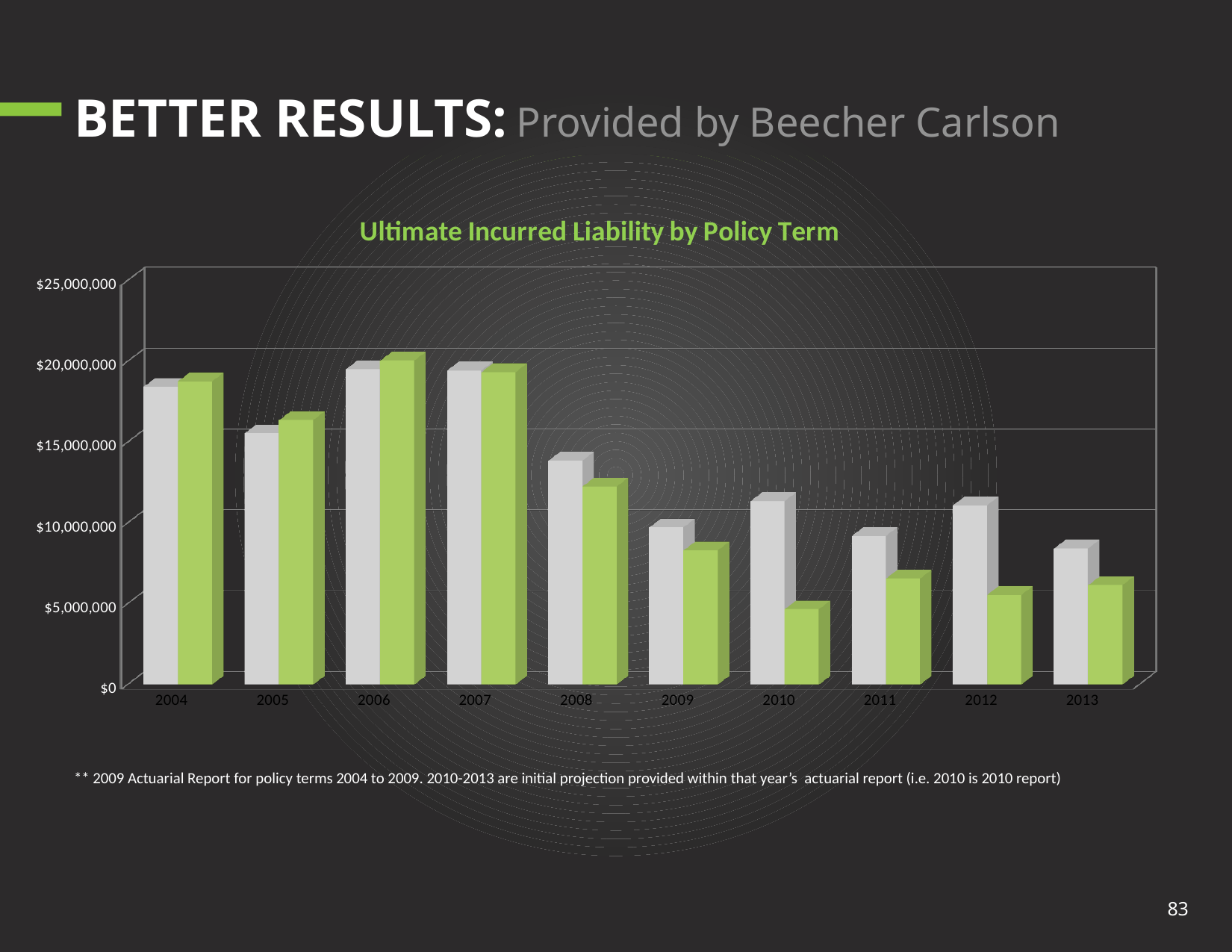
Is the grey bar for 2008 greater or less than $10,000,000? greater For 2010, which bar is taller, the grey bar or the green bar? Grey bar Is the green bar for 2009 greater or less than $10,000,000? less What kind of chart is shown on the slide? Bar chart What is the title of the chart? Ultimate Incurred Liability by Policy Term Overall, do the green bars rise or fall from 2004 to 2013? Fall Which year has the tallest green bar? 2006 Which year has the shortest grey bar? 2013 Is the grey bar for 2004 greater or less than $15,000,000? greater Which year has the shortest green bar? 2010 How many policy terms (years) are shown on the x axis of the chart? 10